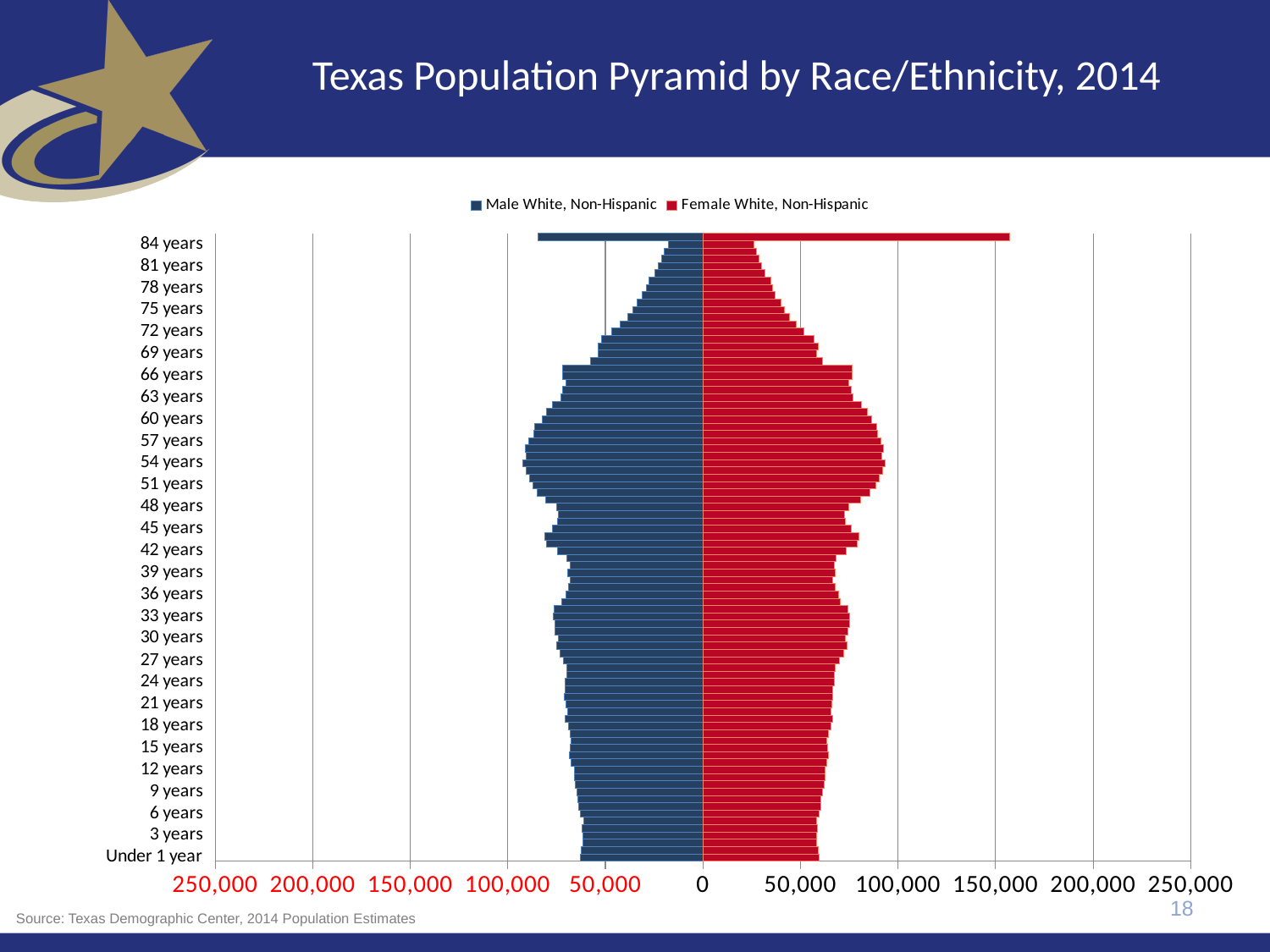
Is the value for Female White, Non-Hispanic at 30 years greater or less than 100,000? less What is the title of the chart? Texas Population Pyramid by Race/Ethnicity, 2014 Moving from 54 years up to 84 years, do the Female White, Non-Hispanic values rise or fall? fall How many series does the legend list? 2 What kind of chart is shown on the slide? bar chart Is the value for Female White, Non-Hispanic at 84 years greater or less than 50,000? less Which is larger for Male White, Non-Hispanic: the value at 54 years or the value at 78 years? 54 years Is the value for Male White, Non-Hispanic at 78 years greater or less than 50,000? less Which series is shown in red? Female White, Non-Hispanic Which is larger for Female White, Non-Hispanic: the value at 54 years or the value at 84 years? 54 years